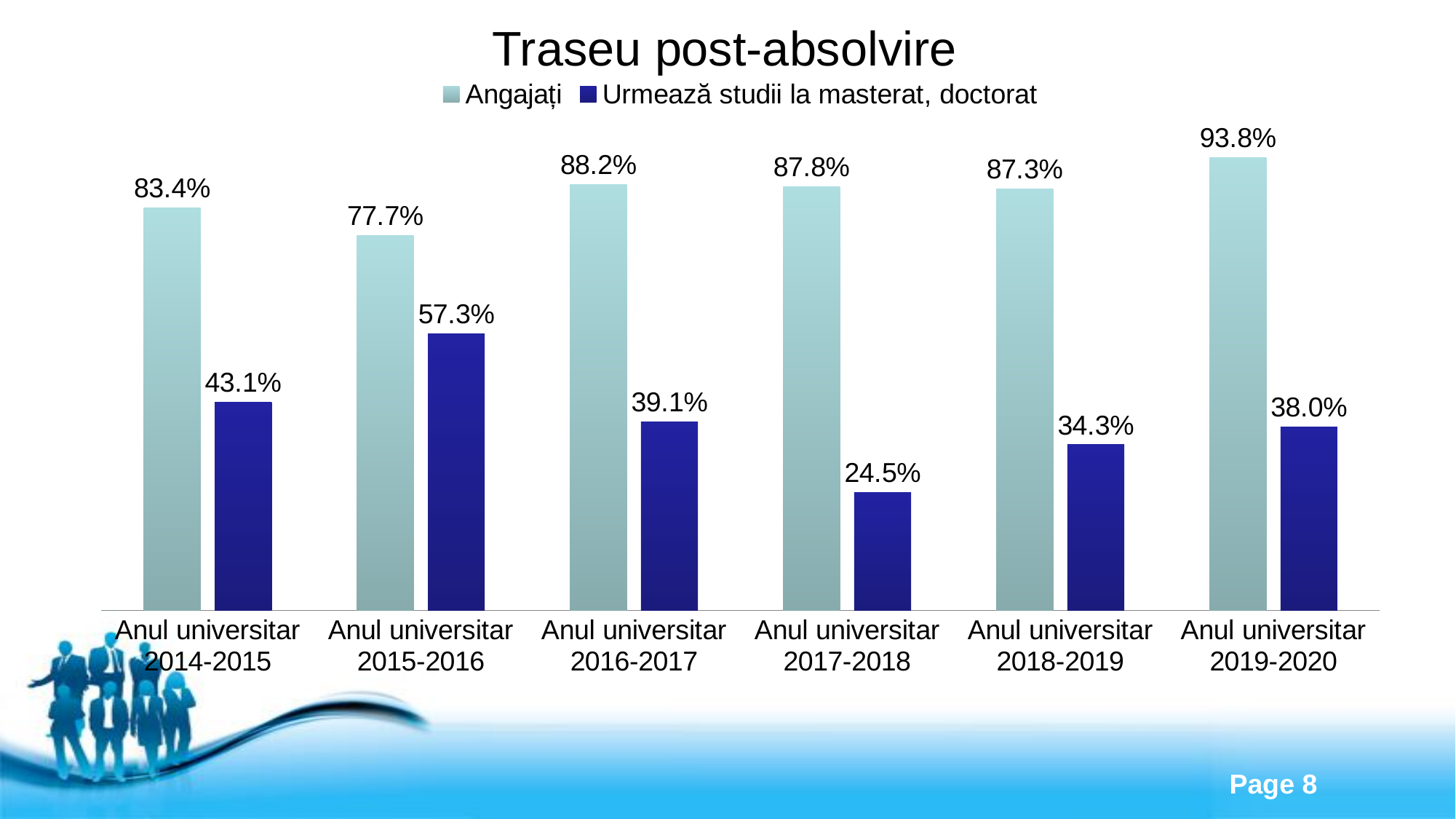
What is the value for Angajați in Anul universitar 2014-2015? 83.4% What is the value for Angajați in Anul universitar 2019-2020? 93.8% What is the title of the chart? Traseu post-absolvire What is the difference between the Angajați value and the Urmează studii la masterat, doctorat value in Anul universitar 2015-2016? 20.4% How many series does the legend list? 2 Which academic year has the highest value for Angajați? Anul universitar 2019-2020 What kind of chart is shown on the slide? Bar chart What is the value for Urmează studii la masterat, doctorat in Anul universitar 2017-2018? 24.5% Which academic year has the lowest value for Angajați? Anul universitar 2015-2016 How many academic years are shown on the x axis? 6 Which is larger: the Urmează studii la masterat, doctorat value in Anul universitar 2014-2015 or in Anul universitar 2019-2020? Anul universitar 2014-2015 Which academic year has the lowest value for Urmează studii la masterat, doctorat? Anul universitar 2017-2018